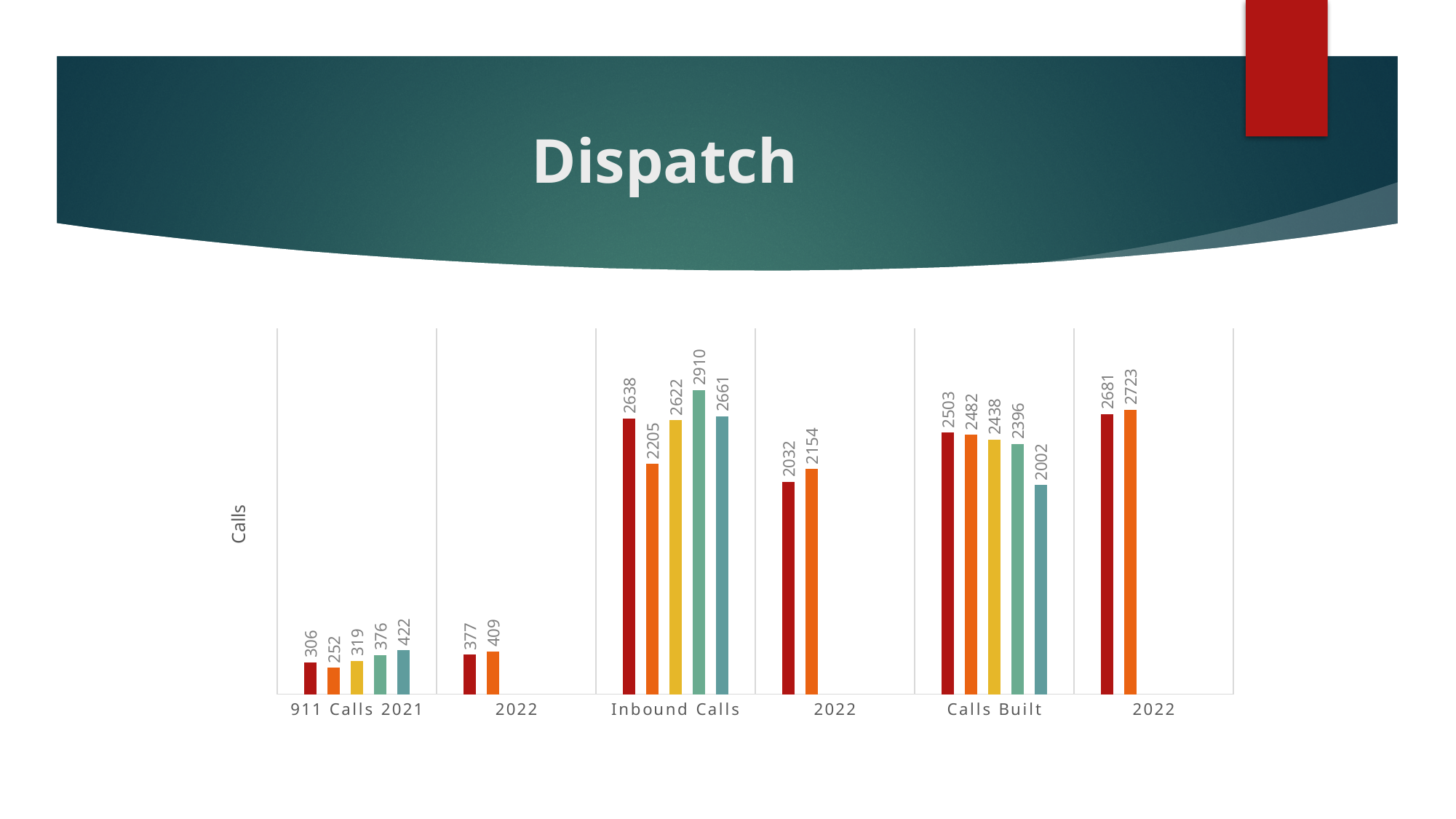
What is the label on the vertical axis of the chart? Calls What is the highest value shown in the Inbound Calls group? 2910 What kind of chart is shown on the slide? Bar chart How many category groups are shown along the x axis? 6 What is the value of the first (dark red) bar in the Calls Built group? 2503 Which is larger: the first (dark red) bar in Inbound Calls or the first (dark red) bar in Calls Built? Inbound Calls What is the difference between the two bars in the 2022 group immediately to the right of Calls Built? 42 What is the highest value shown in the 911 Calls 2021 group? 422 What is the value of the orange bar in the 2022 group immediately to the right of Inbound Calls? 2154 What is the lowest value shown in the Calls Built group? 2002 What is the lowest value shown in the Inbound Calls group? 2205 What is the difference between the two bars in the 2022 group immediately to the right of 911 Calls 2021? 32